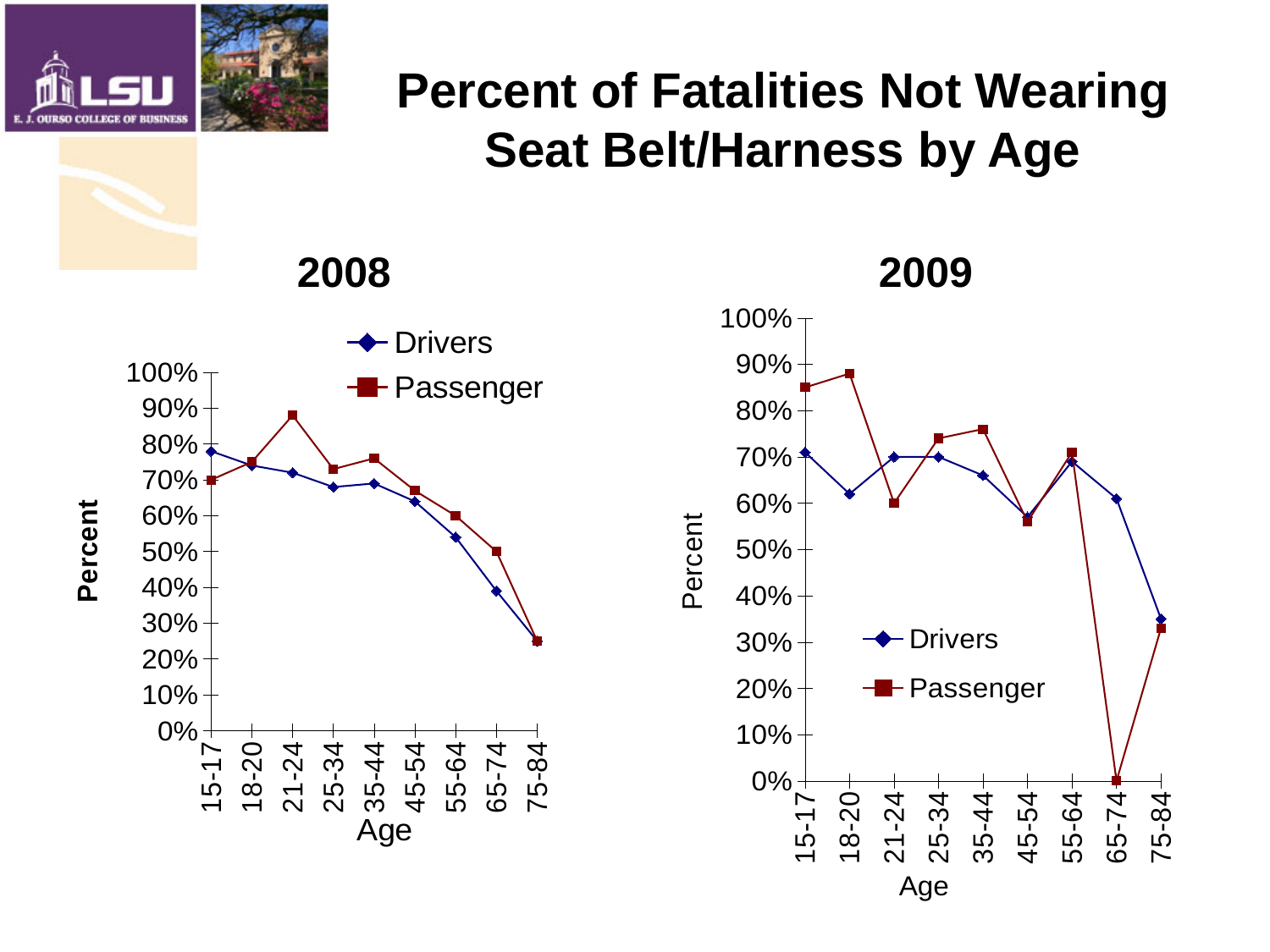
What type of chart is the 2008 chart? line chart In the 2008 chart, which age group has the highest Passenger value? 21-24 How many age groups are shown on the x axis of the 2008 chart? 9 In the 2009 chart, what is the Passenger value for the 65-74 age group? 0% In the 2008 chart, is the Passenger value for the 21-24 age group greater or less than 80%? greater In the 2008 chart, do the Drivers values generally rise or fall as age increases? fall In the 2009 chart, what is the Passenger value for the 21-24 age group? 60% How many series does the legend of the 2009 chart list? 2 In the 2009 chart, is the Drivers value for the 75-84 age group greater or less than 40%? less In the 2009 chart, for the 15-17 age group, which series has the higher value, Drivers or Passenger? Passenger In the 2009 chart, which age group has the lowest Passenger value? 65-74 In the 2008 chart, what is the Passenger value for the 65-74 age group? 50%